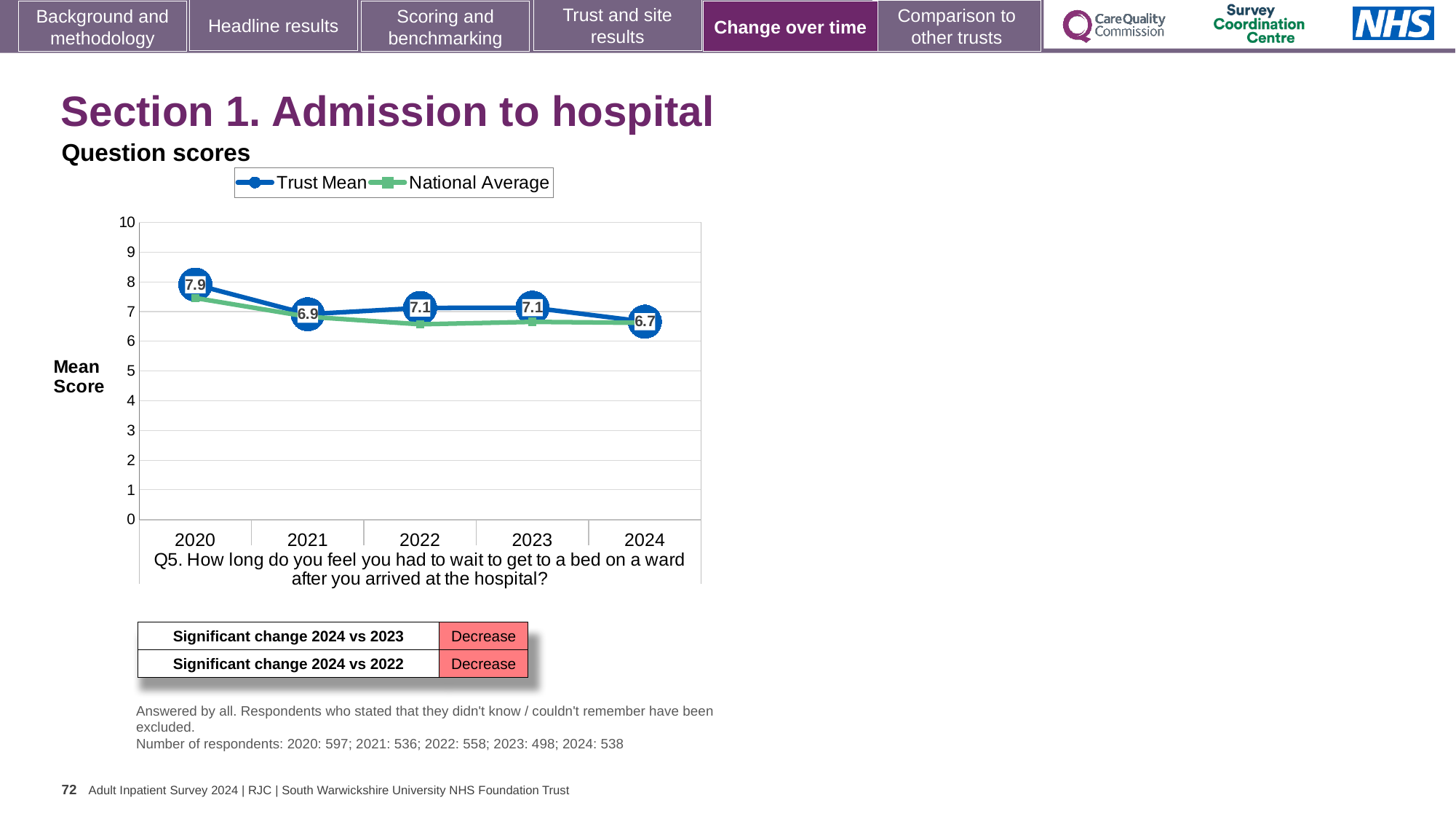
How many series does the legend list? 2 Is the National Average for 2022 greater or less than 7? less In which year is the Trust Mean highest? 2020 How many years are plotted on the x axis? 5 What kind of chart is shown? Line chart In which year is the Trust Mean lowest? 2024 Which is larger, the Trust Mean in 2022 or in 2024? 2022 What is the Trust Mean score for 2020? 7.9 What is the Trust Mean score for 2024? 6.7 What is the difference between the Trust Mean in 2020 and in 2024? 1.2 What is the Trust Mean score for 2021? 6.9 Is the National Average for 2020 greater or less than 7? greater